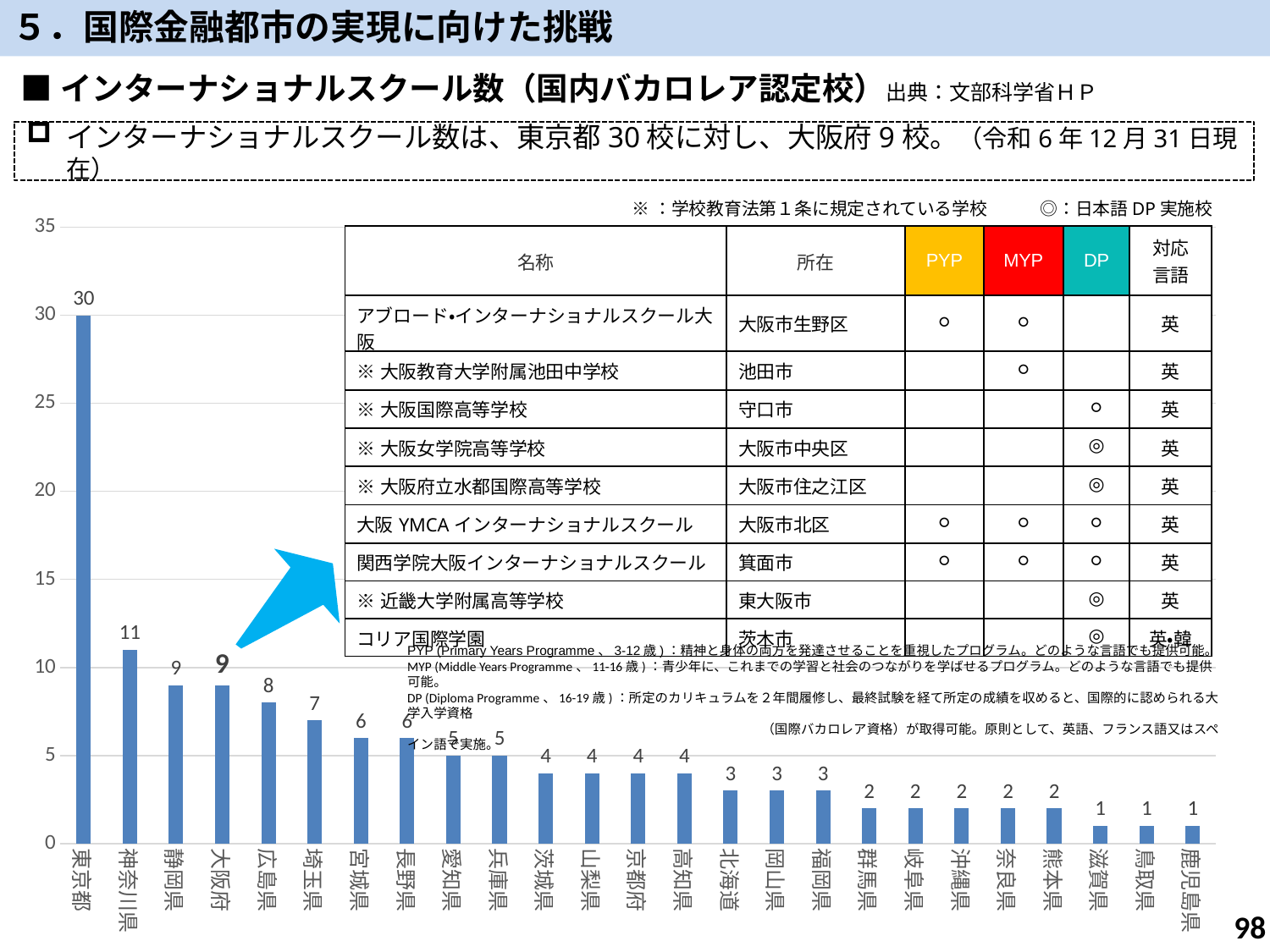
Which prefecture has the highest value? 東京都 How many prefectures are shown on the x axis? 25 Is the value for 東京都 greater or less than 25? greater Do the values rise or fall from left to right along the x axis? fall What is the value for 鹿児島県? 1 What is the difference between the values for 東京都 and 大阪府? 21 Which is larger, the value for 神奈川県 or the value for 埼玉県? 神奈川県 What is the value for 広島県? 8 What kind of chart is shown? bar chart What is the value for 大阪府? 9 What is the value for 東京都? 30 What is the value for 神奈川県? 11